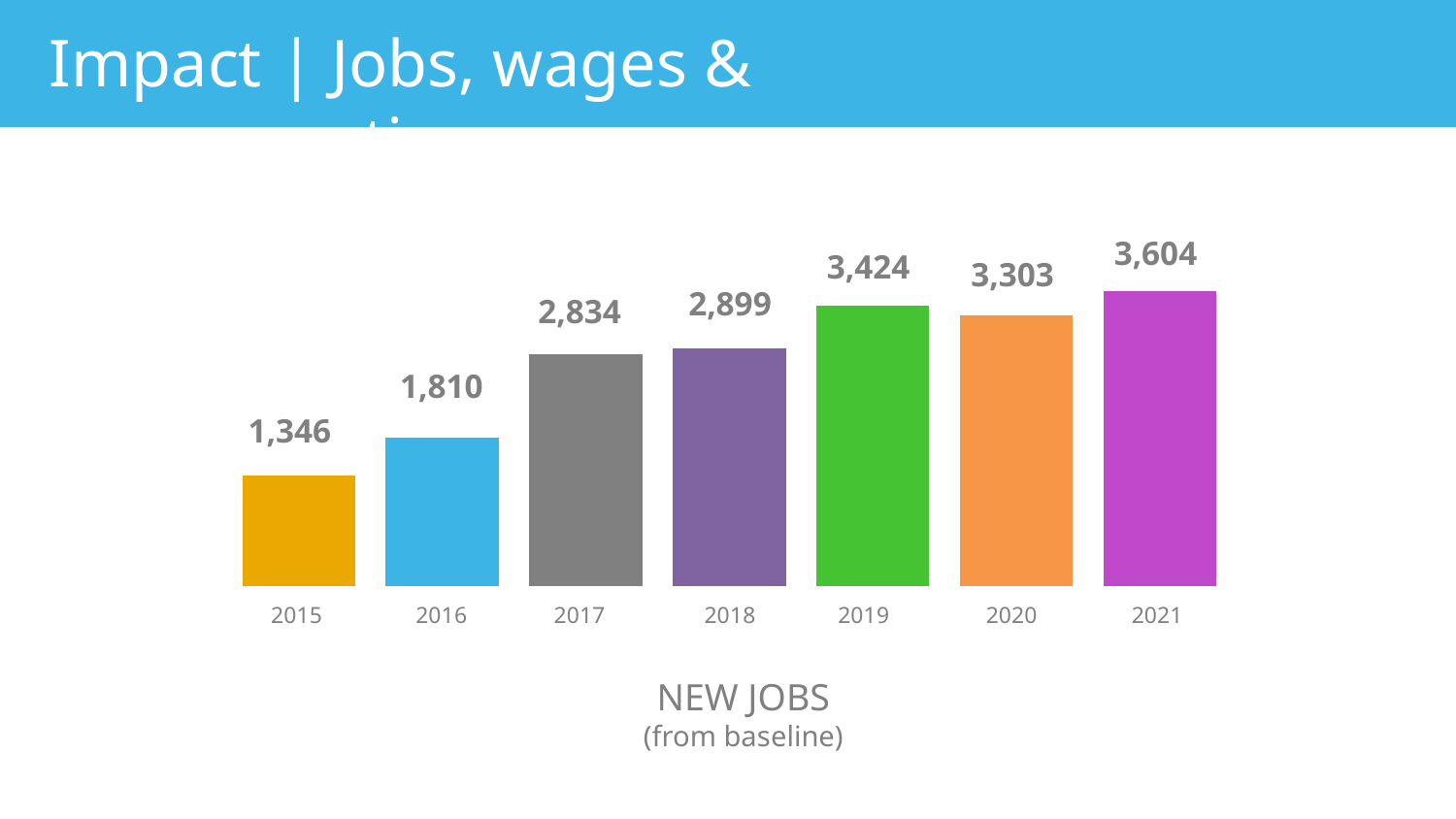
Which year has the lowest value? 2015 Which is larger, the value for 2019 or the value for 2020? 2019 What kind of chart is this? bar chart What is the caption below the chart? NEW JOBS (from baseline) What is the value for 2015? 1,346 What is the difference between the values for 2019 and 2020? 121 What is the value for 2018? 2,899 How many years are shown on the chart? 7 What is the difference between the values for 2021 and 2015? 2,258 Do the values generally rise or fall from 2015 to 2021? rise Which year has the highest value? 2021 What is the value for 2020? 3,303